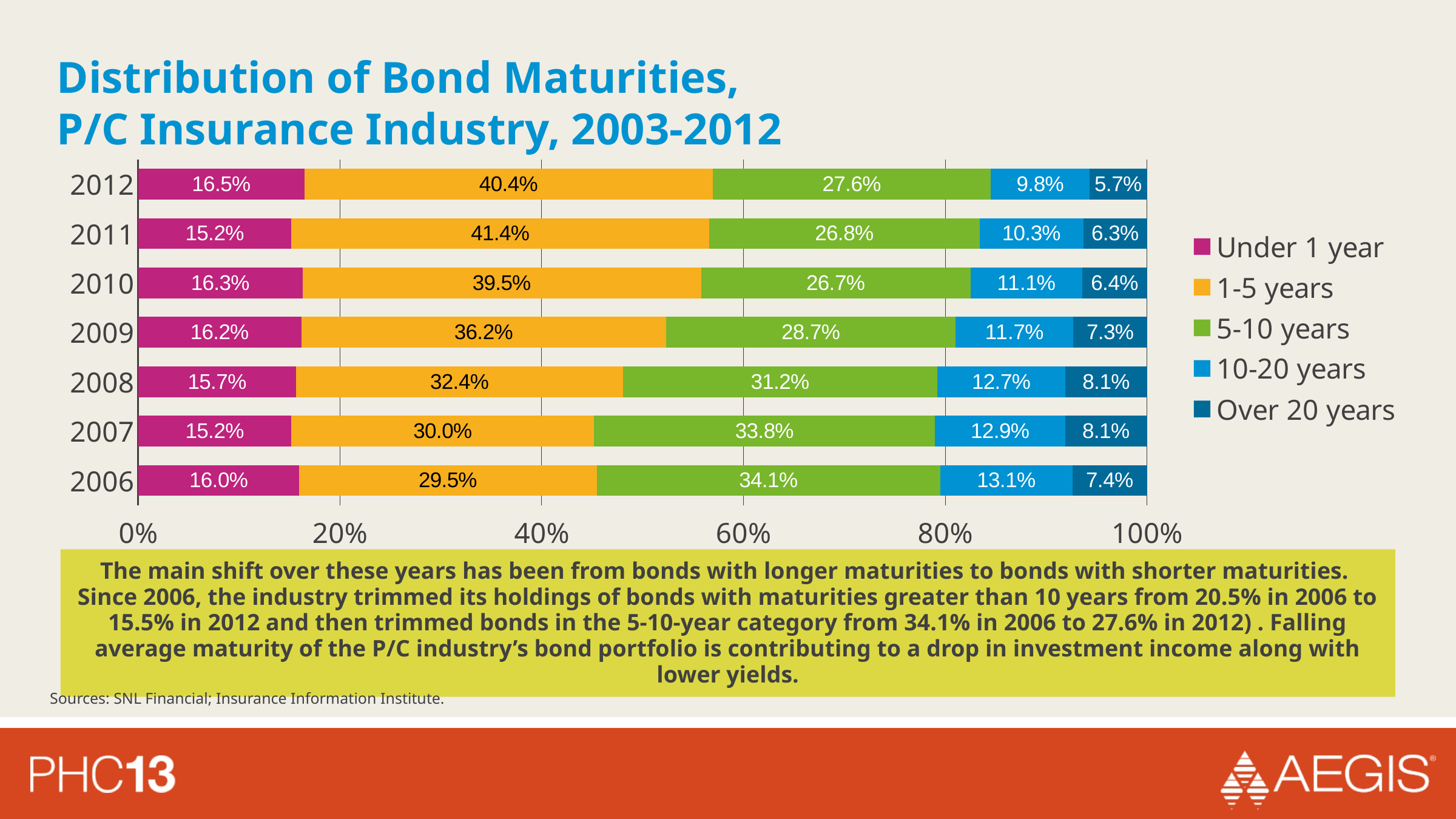
Which year had the larger 1-5 years share, 2007 or 2008? 2008 Does the 10-20 years share rise or fall from 2006 to 2012? Fall What is the combined share of 10-20 years and Over 20 years bonds in 2006? 20.5% In which year was the Over 20 years share the lowest? 2012 How many years are shown on the chart? 7 What kind of chart is shown on the slide? Stacked bar chart In which year was the 1-5 years share the highest? 2011 By how many percentage points did the 5-10 years share fall from 2006 to 2012? 6.5 percentage points How many maturity categories does the legend list? 5 What was the 5-10 years share in 2008? 31.2% What was the Over 20 years share in 2006? 7.4% What share of bonds had maturities of 1-5 years in 2012? 40.4%